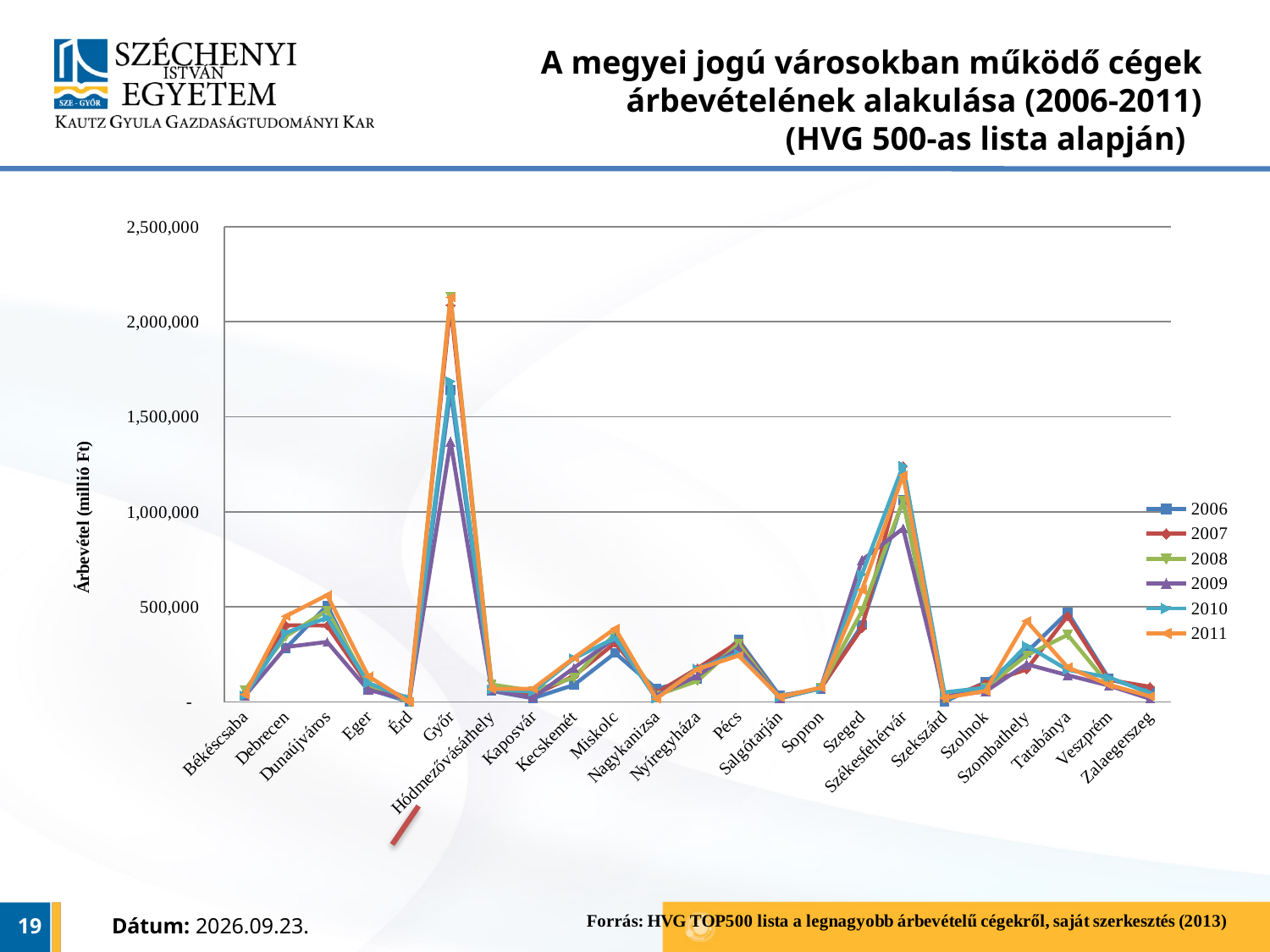
How many series does the legend list? 6 Is the value for Székesfehérvár in 2011 greater or less than 1,000,000? greater How many cities are shown on the x axis? 23 Is the value for Győr in 2011 greater or less than 2,000,000? greater Which years are listed in the legend? 2006, 2007, 2008, 2009, 2010, 2011 Which city has the larger value in 2011, Győr or Székesfehérvár? Győr What kind of chart is shown on the slide? line chart Is the value for Győr in 2009 greater or less than 1,000,000? greater Which city has the highest revenue in the chart? Győr Which city has the larger value in 2011, Miskolc or Érd? Miskolc What is the label of the y axis? Árbevétel (millió Ft)